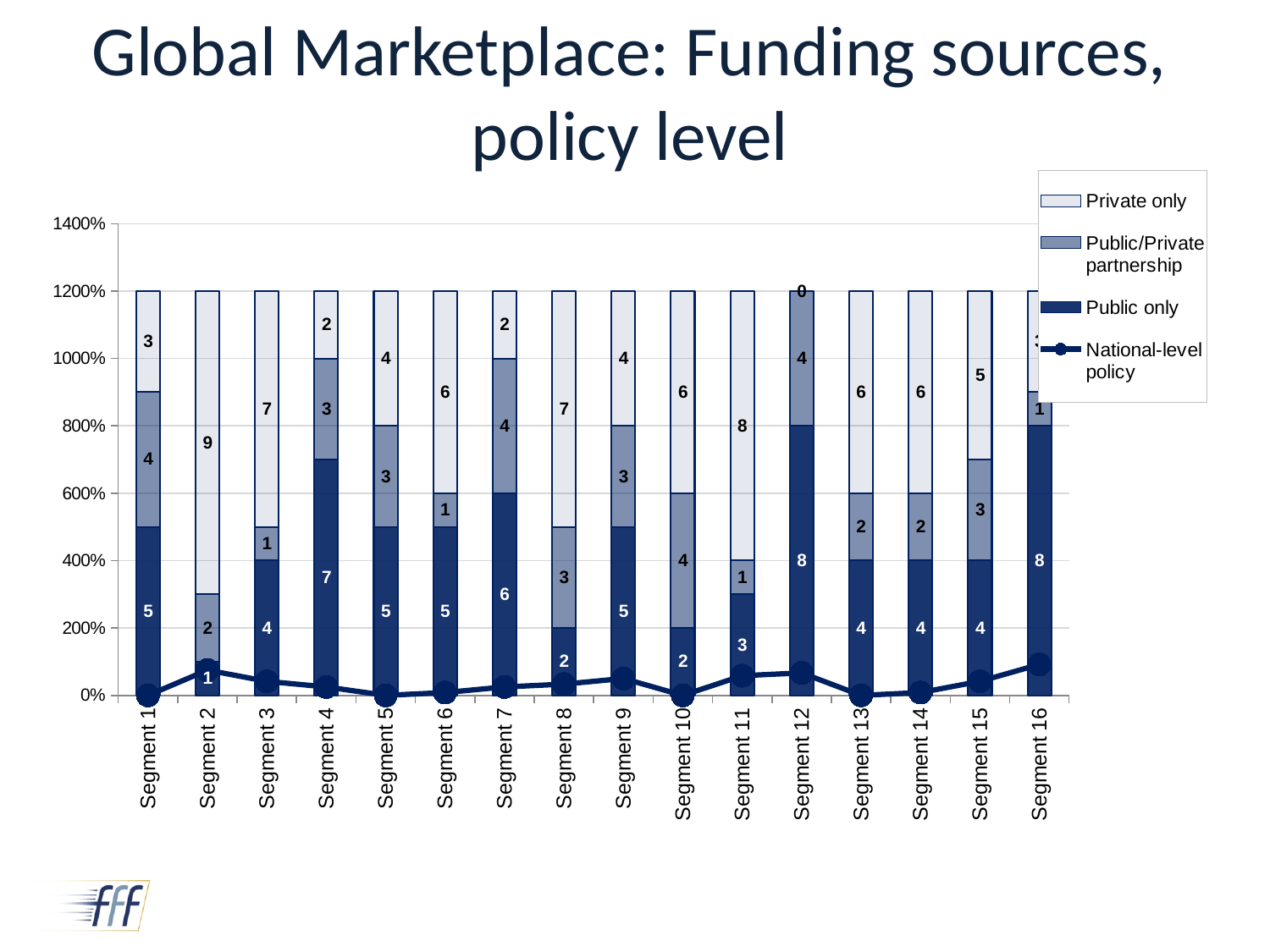
What is the title of the slide? Global Marketplace: Funding sources, policy level Which segment has the lowest Private only value? Segment 12 Which is larger: the Public only value for Segment 4 or for Segment 3? Segment 4 How many series does the legend list? 4 What is the difference between the Private only value and the Public only value for Segment 2? 8 What is the Private only value for Segment 2? 9 What kind of chart is shown on the slide? Stacked bar chart with a line series What is the Public only value for Segment 4? 7 What is the Public/Private partnership value for Segment 10? 4 How many segments are shown on the x axis? 16 Which segment has the highest Private only value? Segment 2 What is the Public only value for Segment 12? 8